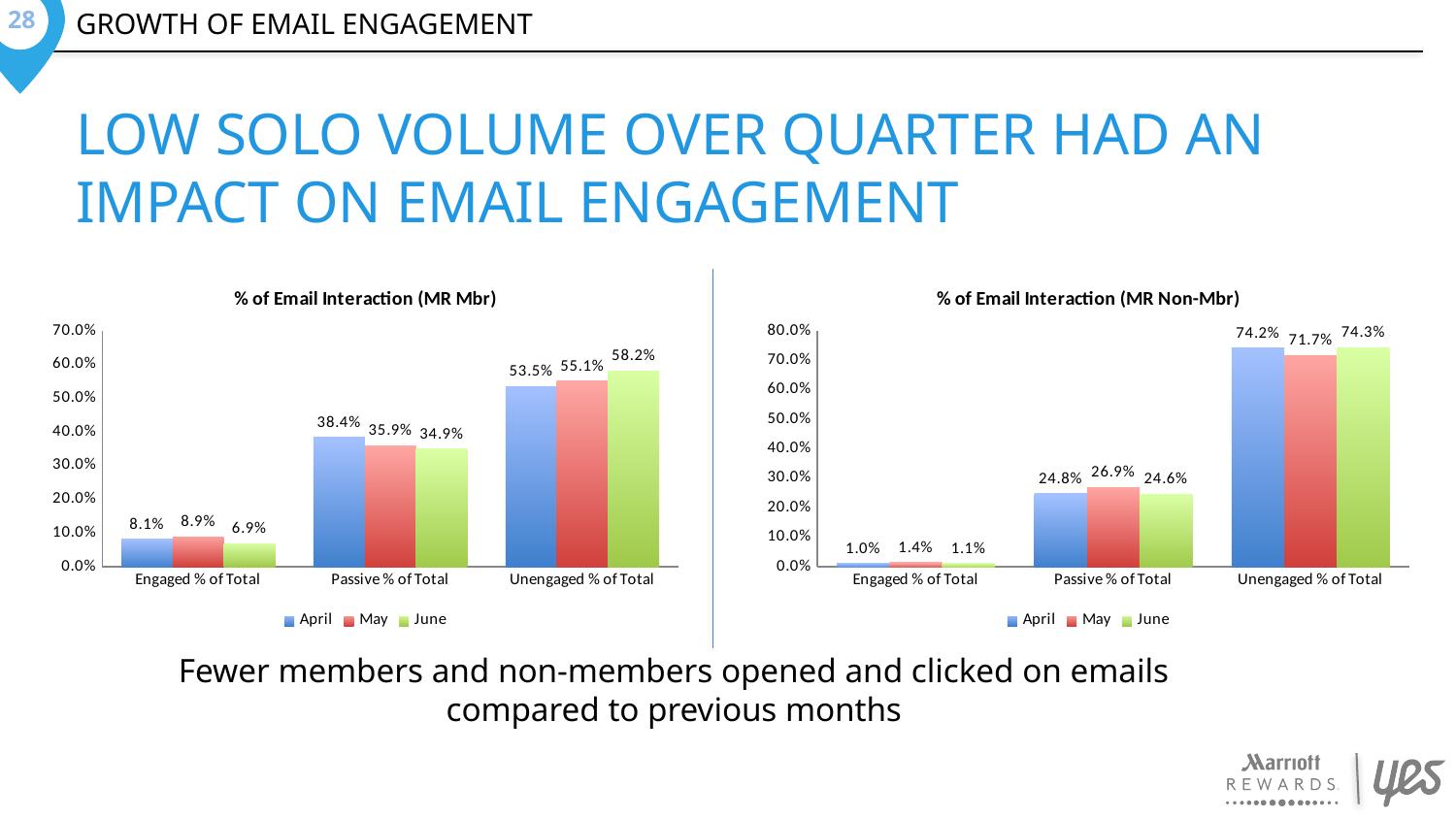
In the '% of Email Interaction (MR Mbr)' chart, what is the April value for Engaged % of Total? 8.1% In the '% of Email Interaction (MR Non-Mbr)' chart, which month has the highest value for Unengaged % of Total? June How many series does the legend of the '% of Email Interaction (MR Mbr)' chart list? 3 How many categories are shown on the x axis of the '% of Email Interaction (MR Non-Mbr)' chart? 3 In the '% of Email Interaction (MR Mbr)' chart, is the May value for Passive % of Total larger or smaller than the June value? larger In the '% of Email Interaction (MR Mbr)' chart, what is the difference between the April and June values for Passive % of Total? 3.5% In the '% of Email Interaction (MR Mbr)' chart, what is the June value for Unengaged % of Total? 58.2% What kind of chart is the '% of Email Interaction (MR Non-Mbr)' chart? Bar chart In the '% of Email Interaction (MR Non-Mbr)' chart, what is the difference between the May and April values for Engaged % of Total? 0.4% In the '% of Email Interaction (MR Non-Mbr)' chart, what is the May value for Passive % of Total? 26.9% In the '% of Email Interaction (MR Mbr)' chart, which month has the lowest value for Engaged % of Total? June In the '% of Email Interaction (MR Mbr)' chart, do the Unengaged % of Total values rise or fall from April to June? rise